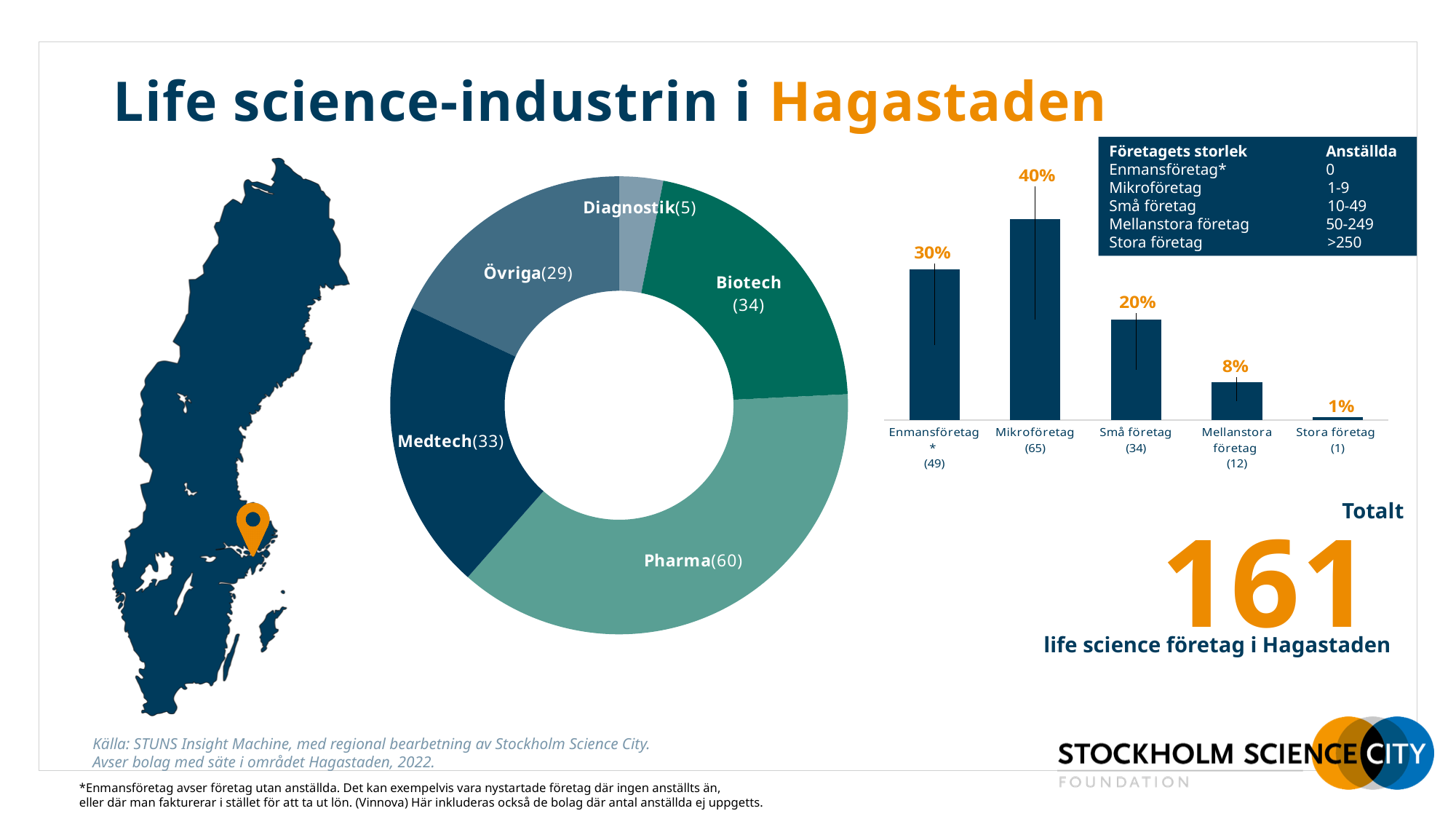
In the bar chart, what percentage is shown for Mikroföretag? 40% In the bar chart, how many companies are in the Mellanstora företag category? 12 How many categories does the donut chart show? 5 In the bar chart, which company size category has the lowest percentage? Stora företag In the bar chart, what is the difference in percentage between Enmansföretag and Små företag? 10% In the bar chart, which company size category has the highest percentage? Mikroföretag In the donut chart, what is the difference between the Biotech and Medtech counts? 1 What kind of chart is the chart in the middle of the slide? Donut chart In the donut chart, which category has the most companies? Pharma What kind of chart is the chart on the right side of the slide? Bar chart In the donut chart, which category has the fewest companies? Diagnostik In the donut chart, how many companies are in the Pharma category? 60